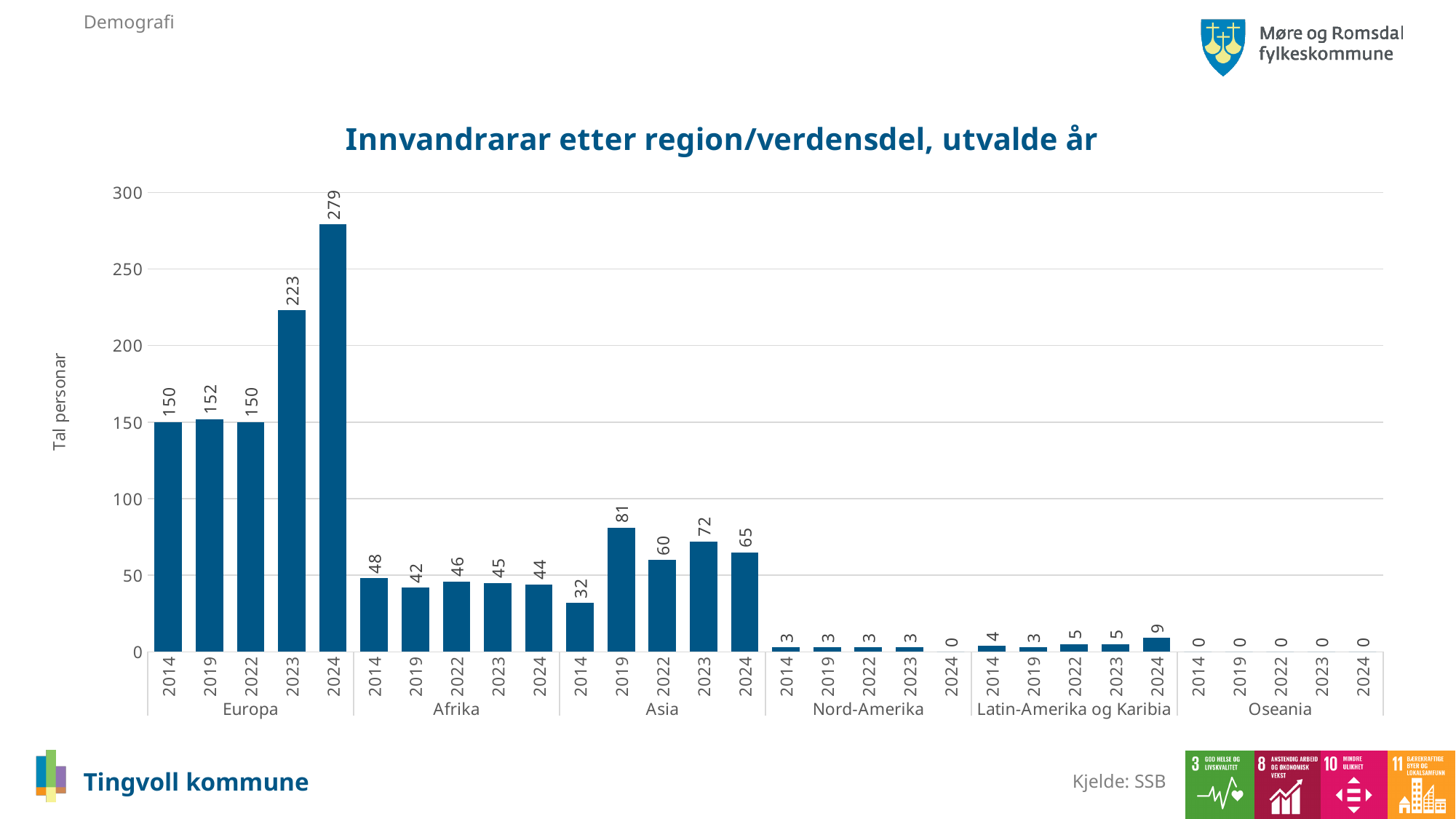
How many region groups are shown on the x axis? 6 What is the value for Afrika in 2014? 48 Is the value for Europa in 2023 greater or less than 200? greater What is the value for Asia in 2019? 81 What is the title of the chart? Innvandrarar etter region/verdensdel, utvalde år What is the value for Latin-Amerika og Karibia in 2024? 9 What is the difference between the Europa values for 2024 and 2023? 56 What kind of chart is this? bar chart Which region has the highest bar on the chart? Europa Which year has the lowest value within the Asia group? 2014 What is the value for Europa in 2024? 279 Which is larger: Afrika in 2014 or Asia in 2014? Afrika in 2014